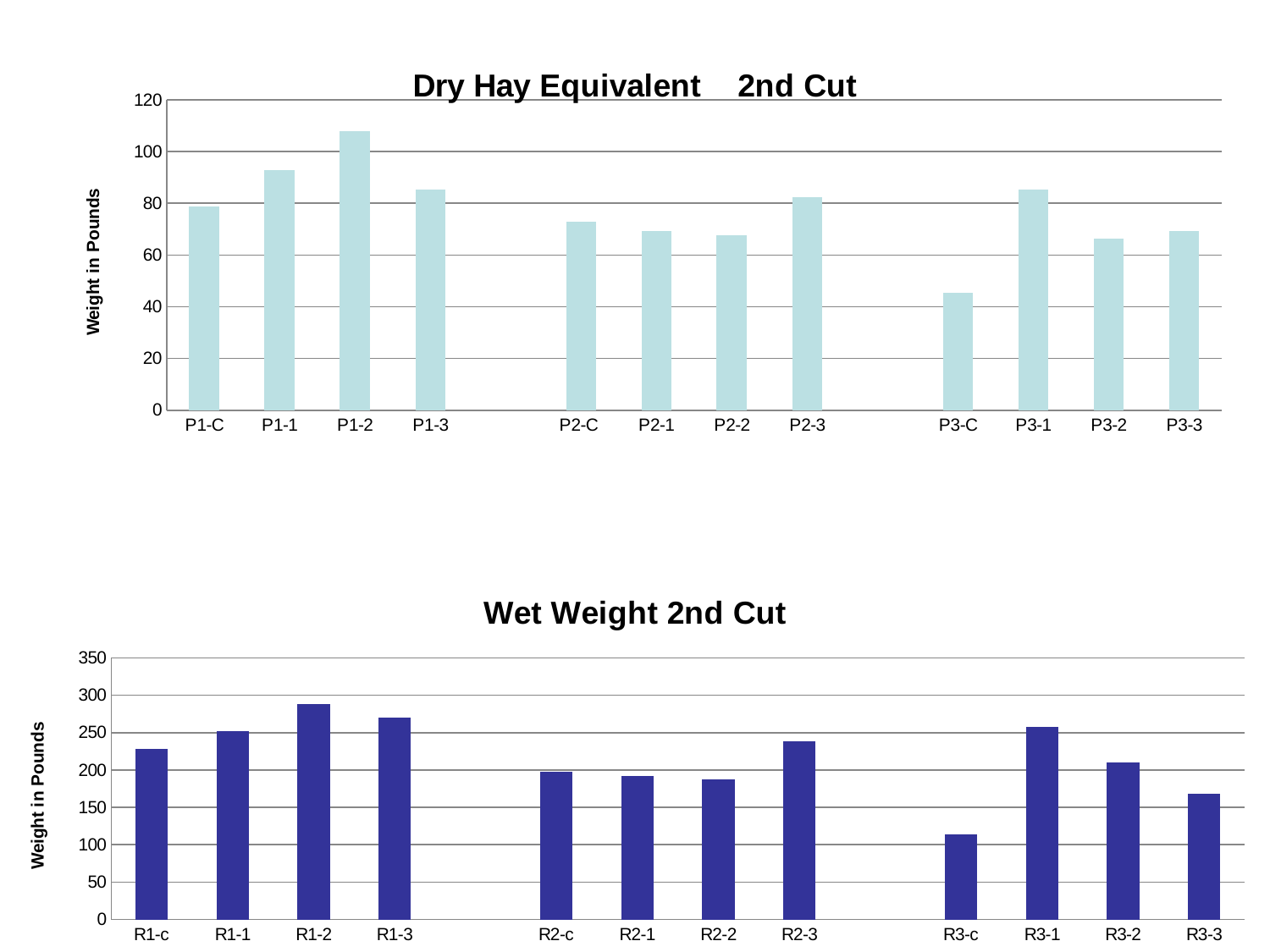
How many bars are plotted in the Dry Hay Equivalent 2nd Cut chart? 12 In the Dry Hay Equivalent 2nd Cut chart, which category has the lowest value? P3-C In the Dry Hay Equivalent 2nd Cut chart, is the value for P3-C greater or less than 60? less In the Dry Hay Equivalent 2nd Cut chart, is the value for P1-2 greater or less than 100? greater What kind of chart is the Wet Weight 2nd Cut chart? bar chart In the Dry Hay Equivalent 2nd Cut chart, which is larger, the value for P1-1 or the value for P2-C? P1-1 In the Dry Hay Equivalent 2nd Cut chart, which category has the highest value? P1-2 In the Wet Weight 2nd Cut chart, which category has the highest value? R1-2 What is the y-axis label of the Dry Hay Equivalent 2nd Cut chart? Weight in Pounds In the Wet Weight 2nd Cut chart, is the value for R3-c greater or less than 150? less In the Wet Weight 2nd Cut chart, which is larger, the value for R3-1 or the value for R3-2? R3-1 In the Wet Weight 2nd Cut chart, which category has the lowest value? R3-c